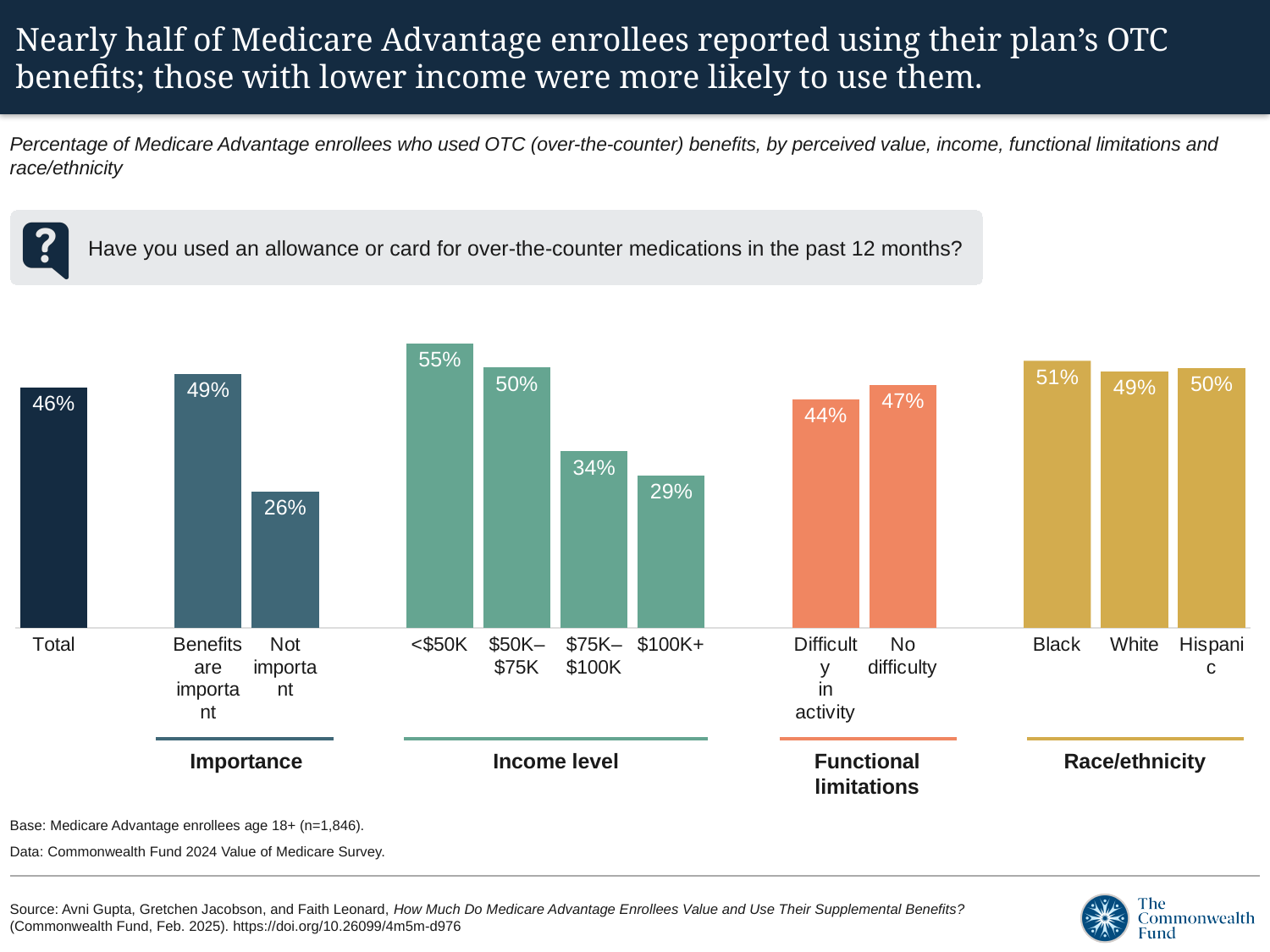
Do the values rise or fall as income level increases from <$50K to $100K+? fall Which category has the lowest percentage of enrollees using OTC benefits? Not important How many bars are plotted in the chart? 12 What is the difference between the values for 'Benefits are important' and 'Not important'? 23 percentage points What is the difference between the values for <$50K and $100K+? 26 percentage points What is the value for Hispanic enrollees? 50% Which is larger, the value for 'Difficulty in activity' or 'No difficulty'? No difficulty What kind of chart is shown on the slide? bar chart Which category has the highest percentage of enrollees using OTC benefits? <$50K What percentage of Medicare Advantage enrollees in total reported using OTC benefits? 46% What is the value for enrollees with income under $50K? 55% What is the value for enrollees who said benefits are not important? 26%